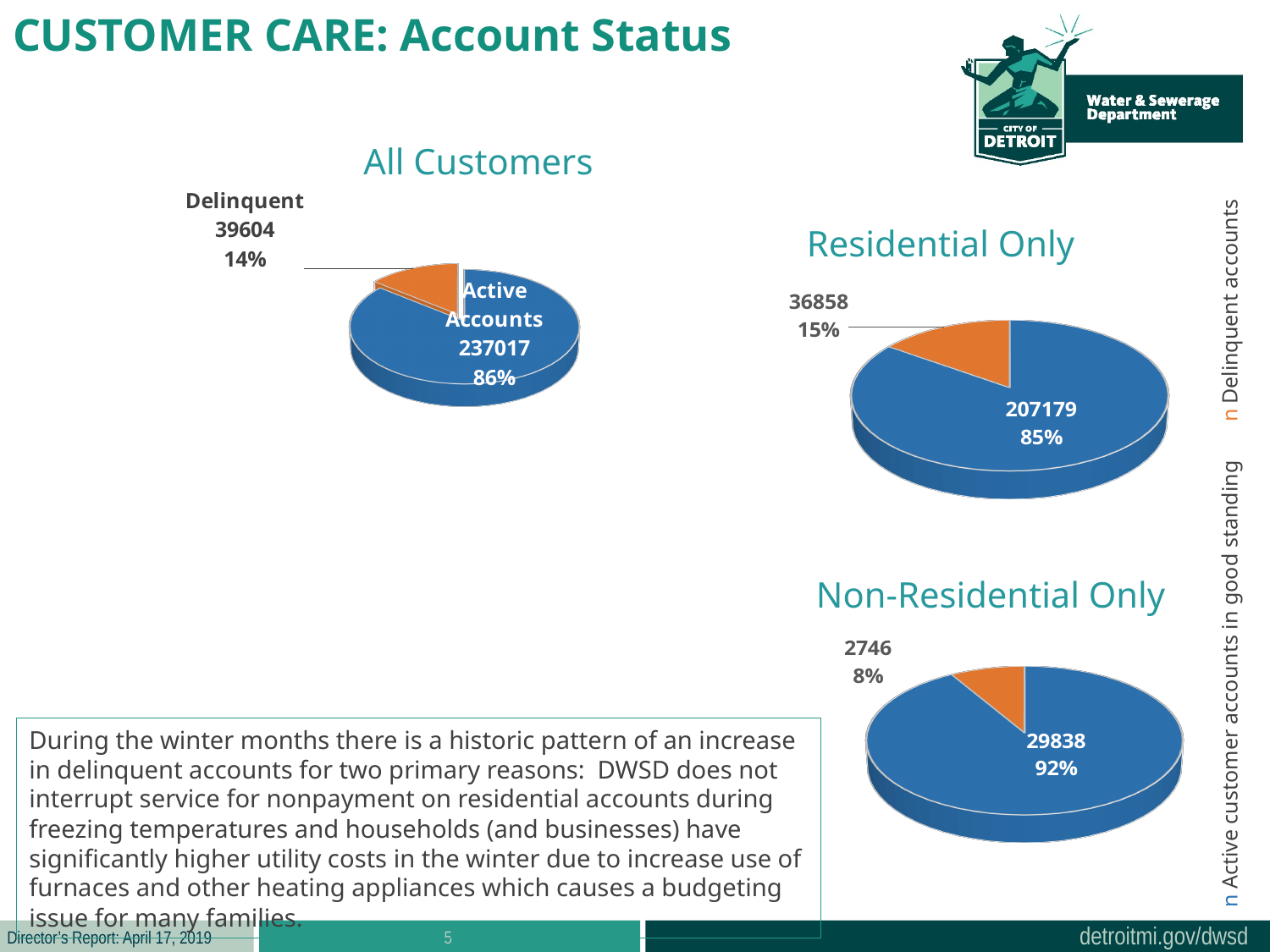
In the All Customers chart, what is the value for Active Accounts? 237017 In the All Customers chart, what is the difference between the Active Accounts value and the Delinquent value? 197413 What type of chart is the Non-Residential Only chart? Pie chart In the All Customers chart, what percentage of accounts are Active Accounts? 86% How many pie charts are on the slide? 3 In the Residential Only chart, what share of accounts is delinquent? 15% According to the legend on the right, what does the orange colour represent? Delinquent accounts In the Non-Residential Only chart, what percentage of accounts are active accounts in good standing? 92% In the Residential Only chart, what is the value of the larger slice? 207179 In the Non-Residential Only chart, what is the value of the delinquent slice? 2746 In the All Customers chart, how many delinquent accounts are shown? 39604 In the Residential Only chart, which slice is larger, the 36858 slice or the 207179 slice? 207179